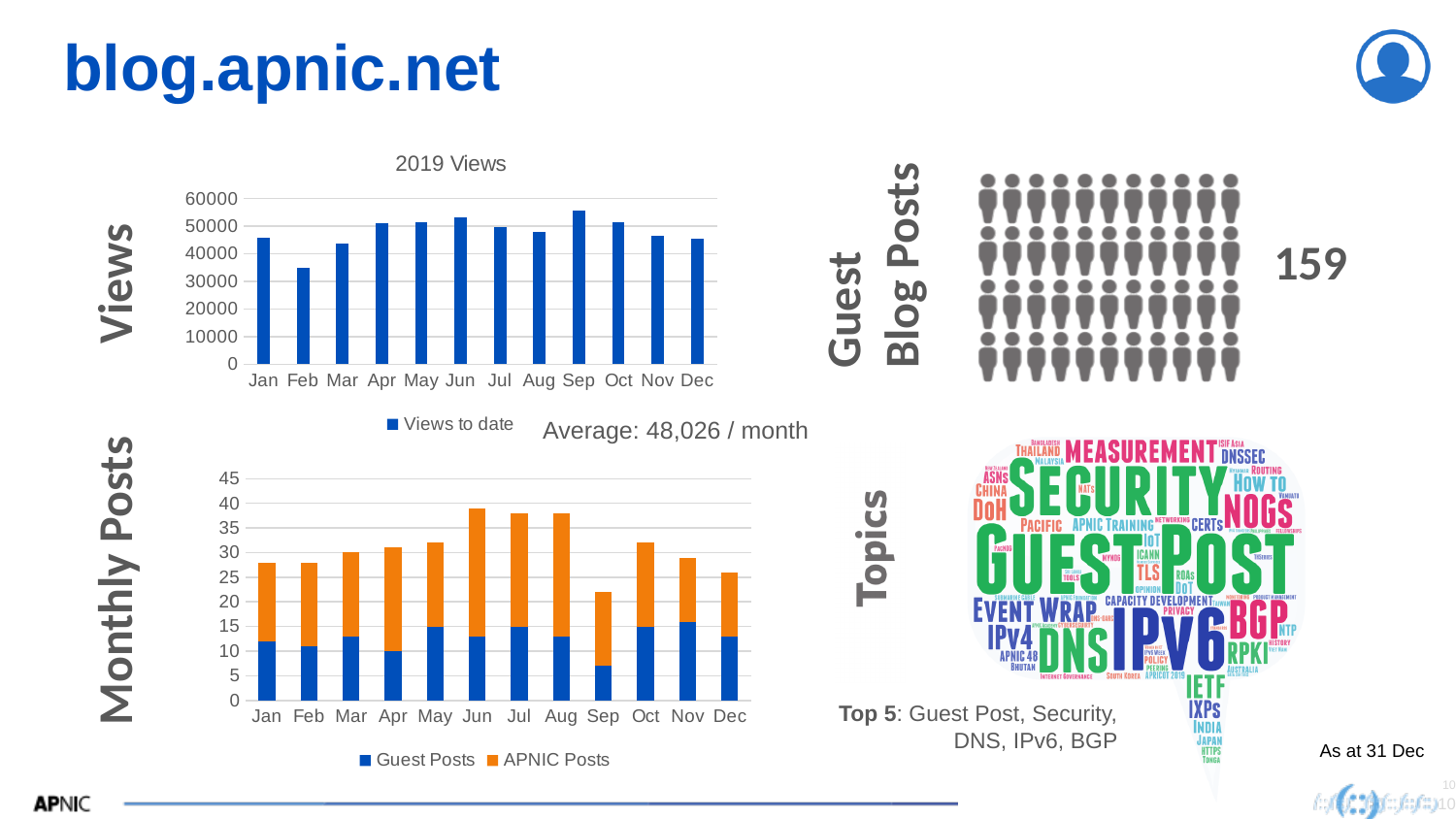
In the 2019 Views chart, is the value for Feb greater or less than 40000? less In the 2019 Views chart, which month has more views, Feb or Sep? Sep How many series does the legend of the Monthly Posts chart list? 2 In the Monthly Posts chart, is the total for Jun greater or less than 35? greater How many months are plotted in the 2019 Views chart? 12 In the 2019 Views chart, which month has the highest number of views? Sep What are the two series named in the legend of the Monthly Posts chart? Guest Posts and APNIC Posts In the Monthly Posts chart, which month has the highest total number of posts? Jun In the 2019 Views chart, which month has the lowest number of views? Feb In the Monthly Posts chart, which month has the lowest total number of posts? Sep In the 2019 Views chart, is the value for Sep greater or less than 50000? greater What kind of chart is the 2019 Views chart? bar chart